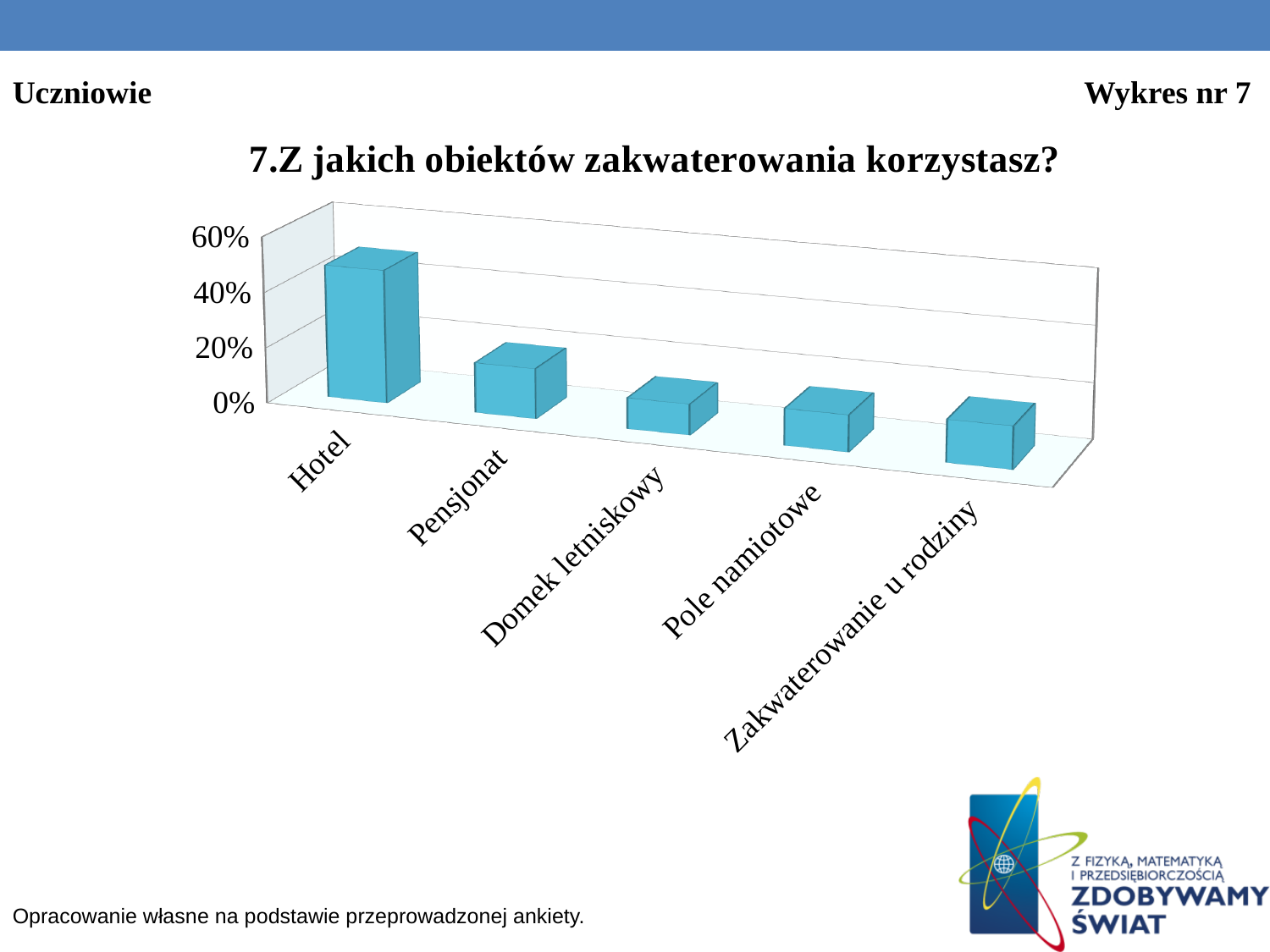
Which is larger, the value for Hotel or the value for Pensjonat? Hotel Is the value for Zakwaterowanie u rodziny greater or less than 40%? less How many categories are shown on the x axis of the chart? 5 Which category has the highest value in the chart? Hotel What is the title of the chart? 7.Z jakich obiektów zakwaterowania korzystasz? Is the value for Pensjonat greater or less than 40%? less Which is larger, the value for Pensjonat or the value for Pole namiotowe? Pensjonat Is the value for Hotel greater or less than 60%? less Do the values generally rise or fall from left to right along the x axis? fall What kind of chart is shown on the slide? bar chart